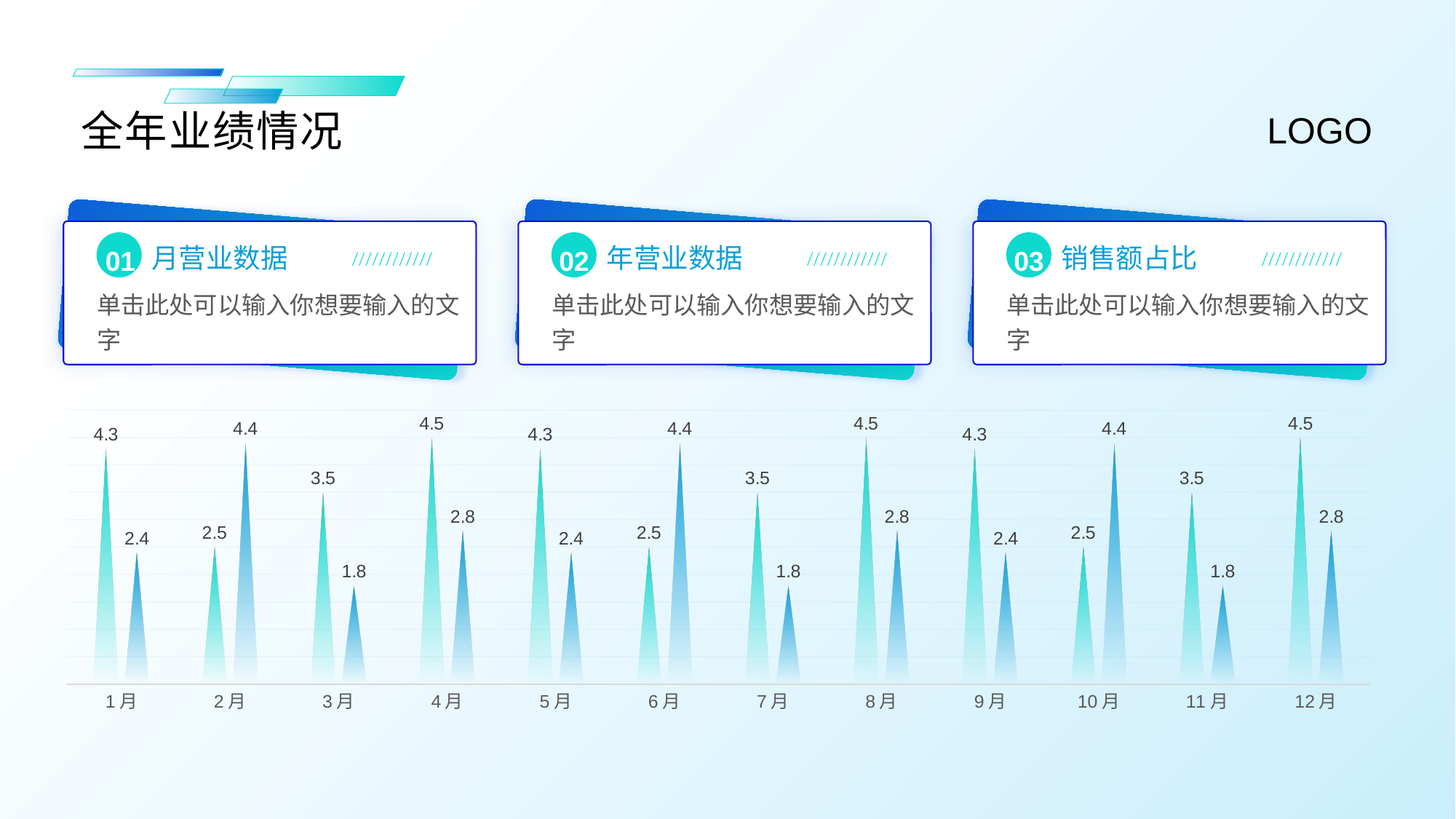
What kind of chart is shown on the slide? bar chart What is the value of the blue (second) bar for 3月? 1.8 What is the value of the green (first) bar for 11月? 3.5 For 1月, which bar is larger, the green (first) bar or the blue (second) bar? the green (first) bar What is the difference between the green (first) bar and the blue (second) bar for 12月? 1.7 For 6月, which bar is larger, the green (first) bar or the blue (second) bar? the blue (second) bar What is the value of the blue (second) bar for 2月? 4.4 What is the value of the green (first) bar for 1月? 4.3 What is the value of the green (first) bar for 4月? 4.5 What is the value of the blue (second) bar for 8月? 2.8 How many months (categories) are shown on the x axis? 12 What is the difference between the two bars for 3月? 1.7